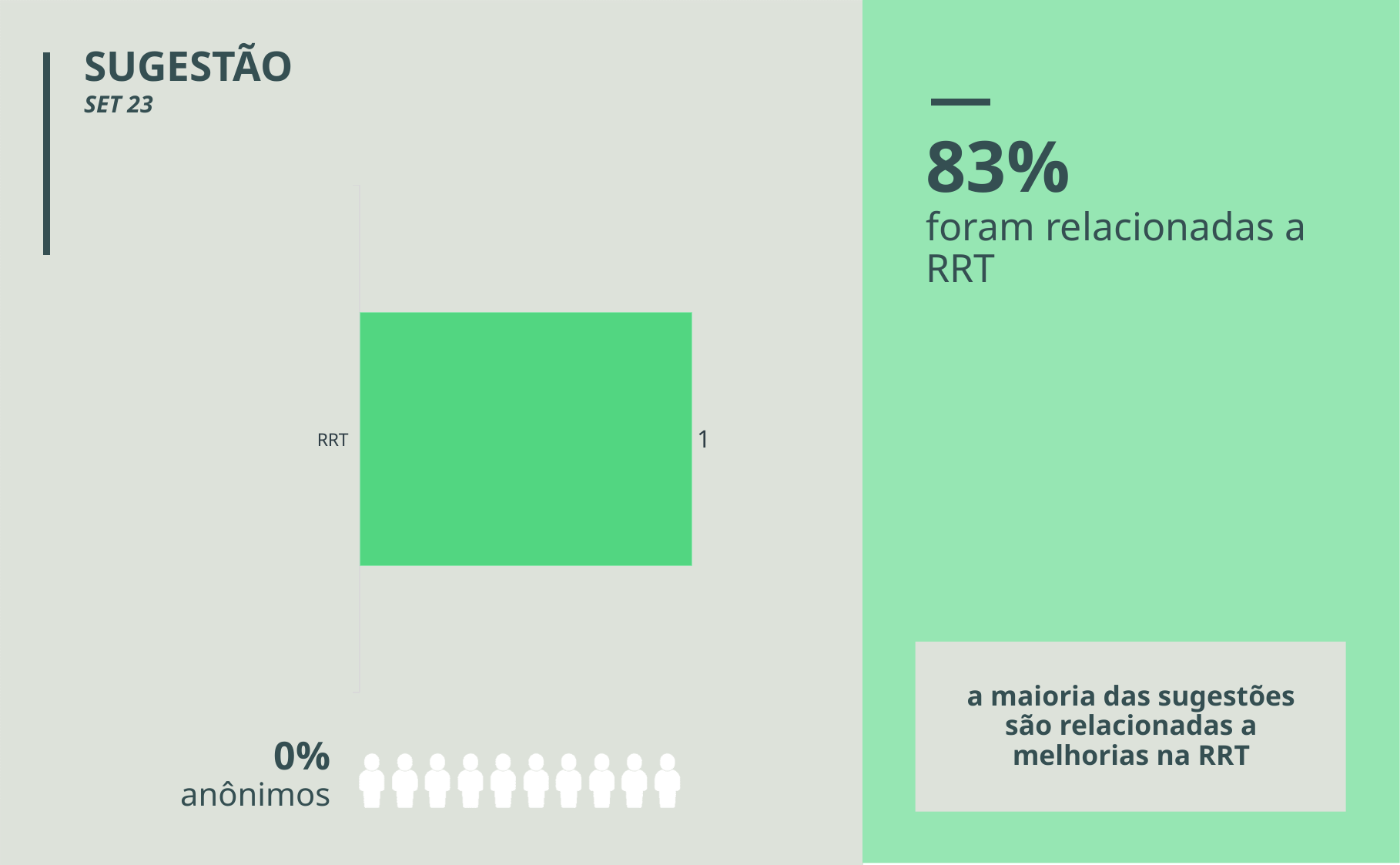
Which category has the highest value in the bar chart? RRT Are the bars in the chart horizontal or vertical? horizontal What colour is the bar for RRT in the chart? green How many categories are plotted in the bar chart? 1 What is the label of the only category in the bar chart? RRT What kind of chart is shown on the slide? bar chart What is the value shown for RRT in the bar chart? 1